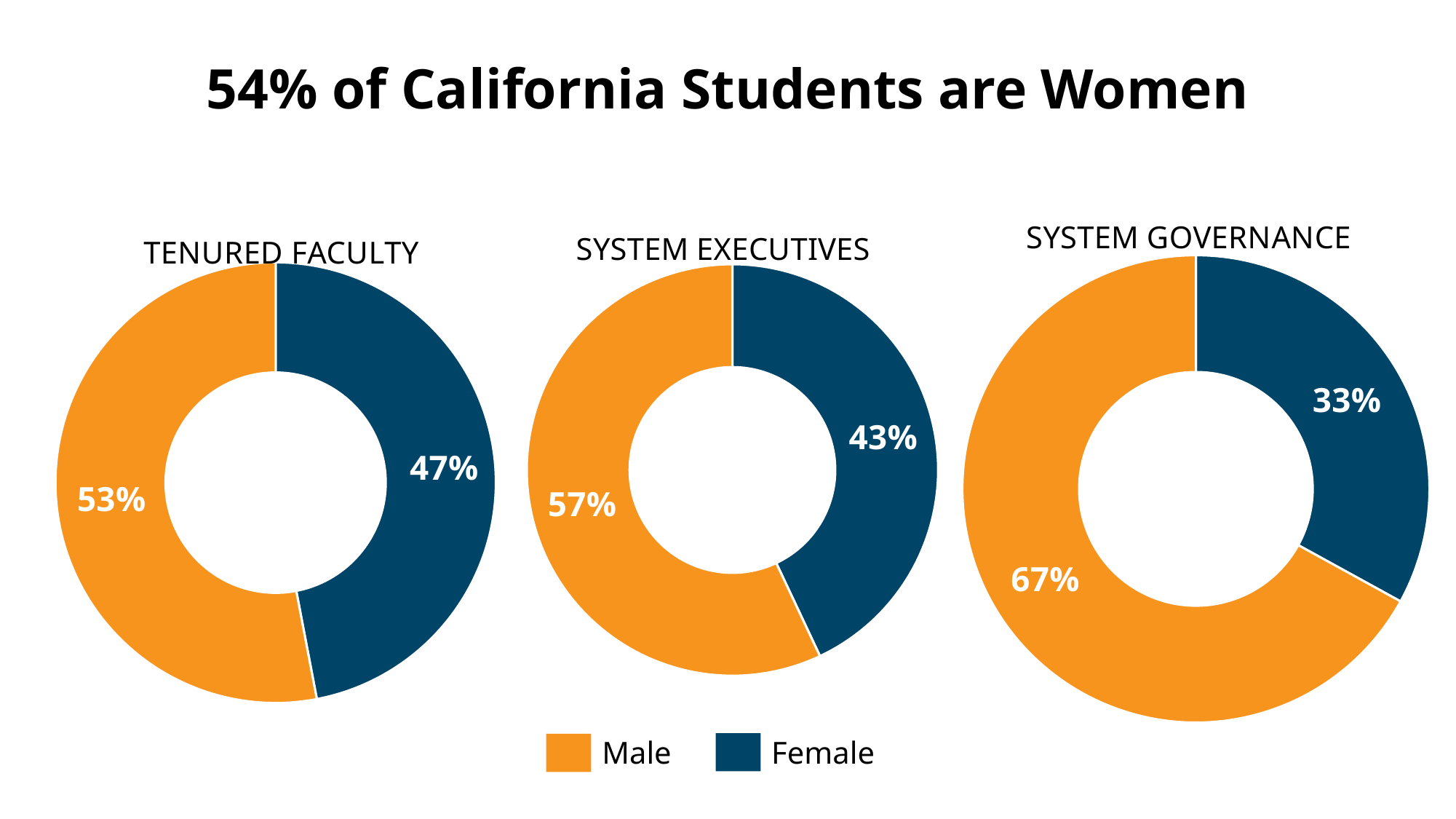
What is the title of the slide above the charts? 54% of California Students are Women In the System Executives chart, what percentage is Male? 57% In the System Governance chart, what is the difference between the Male and Female percentages? 34% In the System Governance chart, what percentage is Female? 33% In the Tenured Faculty chart, what percentage is Female? 47% In the Tenured Faculty chart, what percentage is Male? 53% In the System Governance chart, what percentage is Male? 67% In the System Governance chart, which slice is larger, Male or Female? Male What kind of chart is the Tenured Faculty chart? Pie chart (donut) In the System Executives chart, what percentage is Female? 43% How many series does the legend list? 2 In the System Executives chart, what is the difference between the Male and Female percentages? 14%